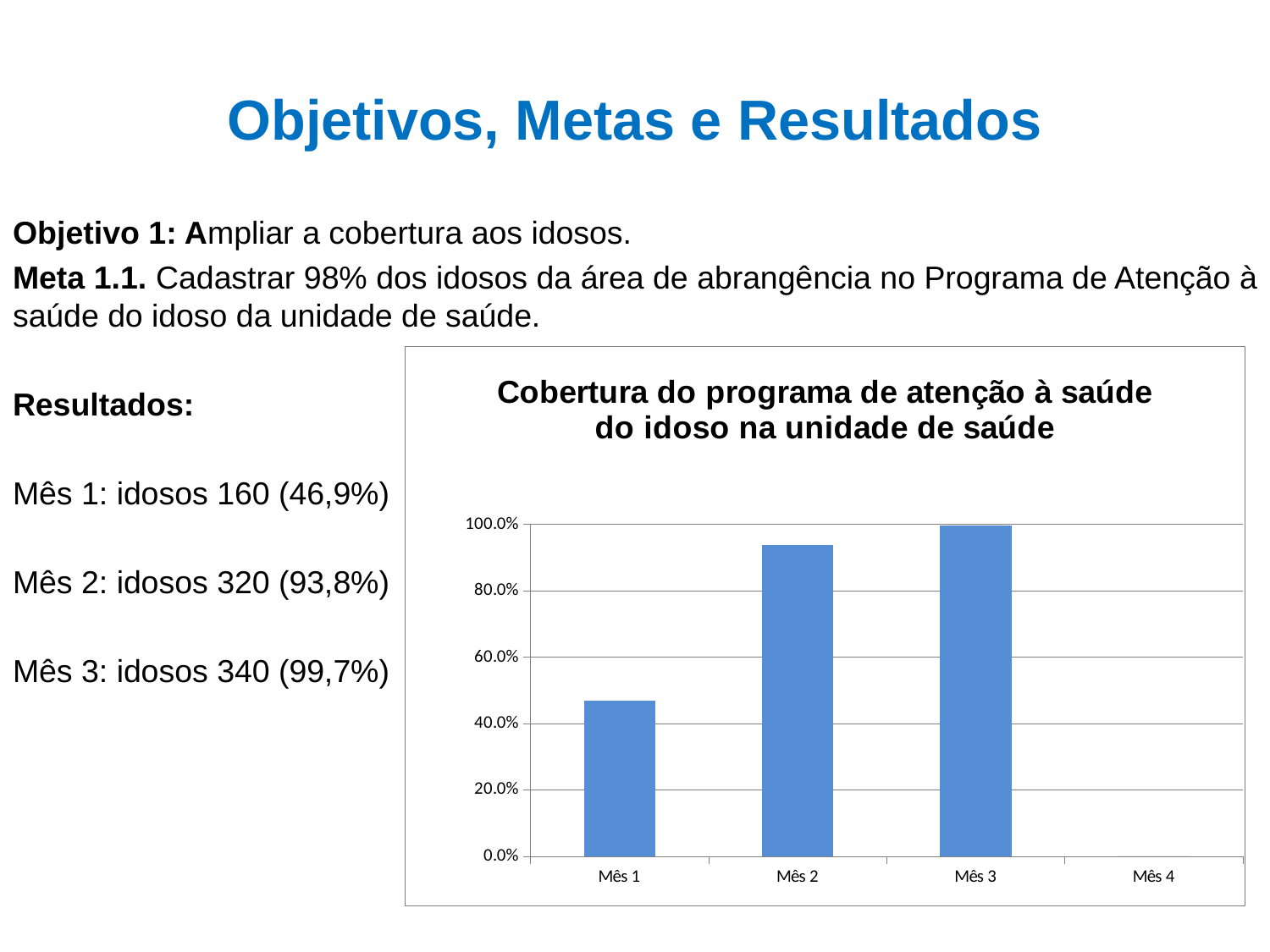
Which is larger, the value for Mês 1 or the value for Mês 2? Mês 2 Do the bar values rise or fall from Mês 1 to Mês 3? rise How many bars are plotted in the chart? 3 What is the title of the chart? Cobertura do programa de atenção à saúde do idoso na unidade de saúde Is the value for Mês 1 greater or less than 40.0%? greater How many categories are shown on the x axis of the chart? 4 Which month has the highest bar in the chart? Mês 3 Which category on the x axis has no bar plotted? Mês 4 Among the months with a plotted bar, which has the lowest value? Mês 1 Is the value for Mês 1 greater or less than 60.0%? less Is the value for Mês 2 greater or less than 80.0%? greater What kind of chart is shown on the slide? Bar chart